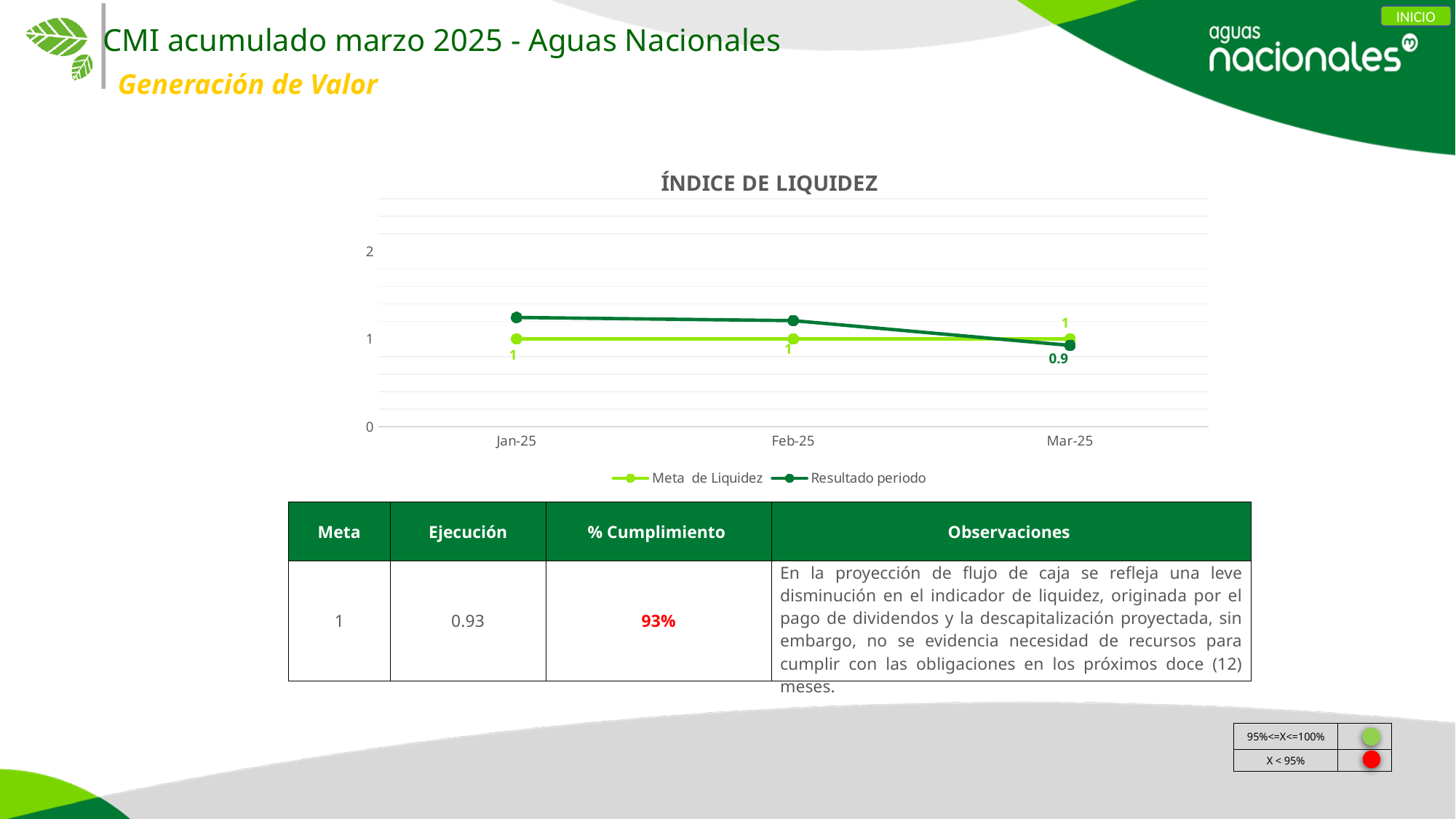
What is the title of the chart? ÍNDICE DE LIQUIDEZ Is the value of Resultado periodo for Jan-25 greater or less than 1? greater How many periods are plotted along the x axis of the chart? 3 What kind of chart is shown on the slide? line chart How many series does the legend of the ÍNDICE DE LIQUIDEZ chart list? 2 What is the value of Meta de Liquidez for Mar-25? 1 In which period is Resultado periodo at its lowest? Mar-25 What is the value of Resultado periodo for Mar-25? 0.9 In Mar-25, which is larger: Meta de Liquidez or Resultado periodo? Meta de Liquidez Does the Resultado periodo series rise or fall from Jan-25 to Mar-25? fall What is the difference between Meta de Liquidez and Resultado periodo in Mar-25? 0.1 What is the value of Meta de Liquidez for Jan-25? 1